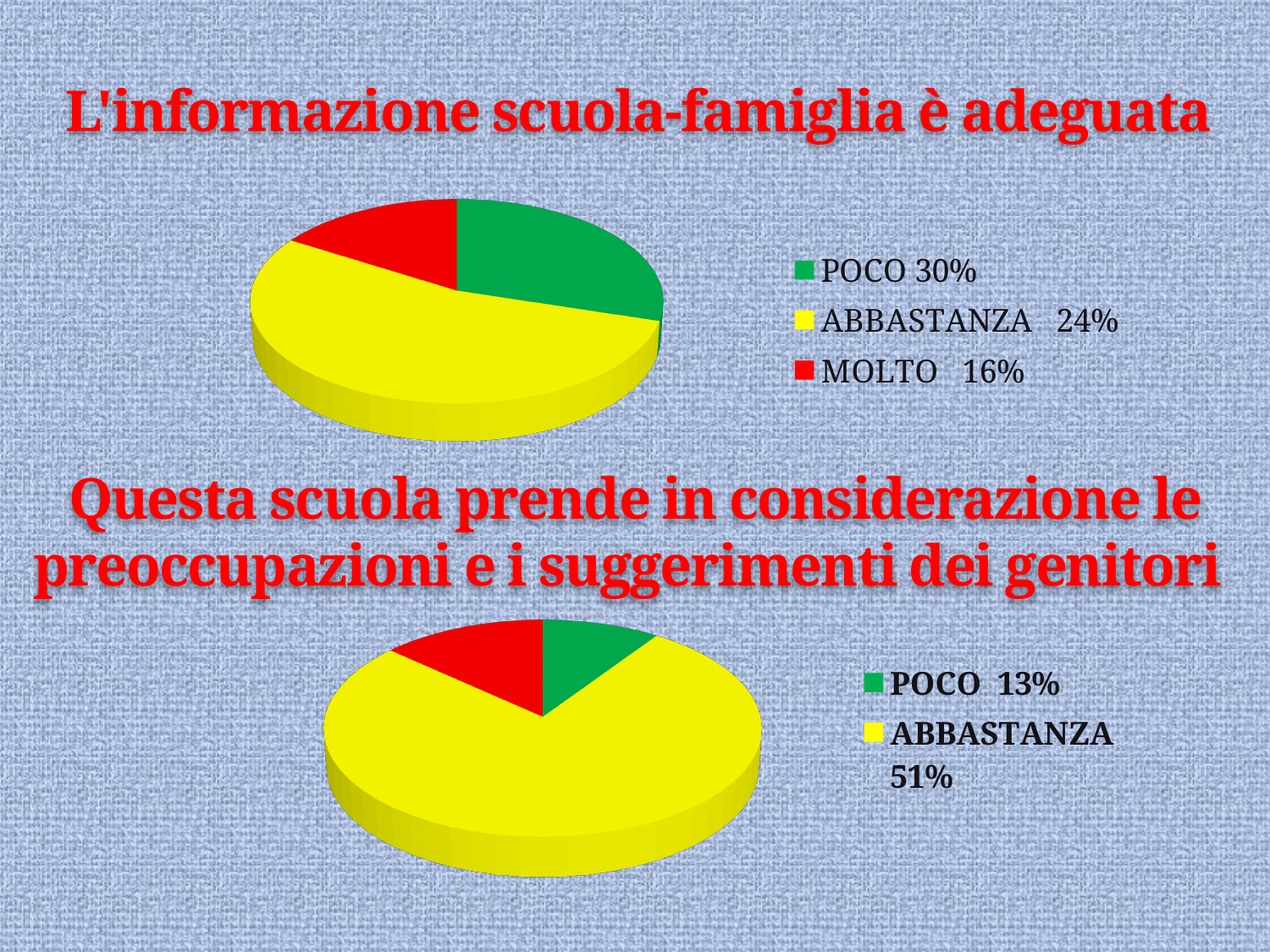
In the chart "Questa scuola prende in considerazione le preoccupazioni e i suggerimenti dei genitori", what percentage is shown for ABBASTANZA? 51% In the chart "L'informazione scuola-famiglia è adeguata", what percentage is shown for MOLTO? 16% How many entries does the legend of the chart "L'informazione scuola-famiglia è adeguata" list? 3 In the chart "Questa scuola prende in considerazione le preoccupazioni e i suggerimenti dei genitori", what is the difference between the percentages for ABBASTANZA and POCO? 38% In the chart "L'informazione scuola-famiglia è adeguata", what percentage is shown for POCO? 30% How many entries does the legend of the chart "Questa scuola prende in considerazione le preoccupazioni e i suggerimenti dei genitori" list? 2 In the chart "Questa scuola prende in considerazione le preoccupazioni e i suggerimenti dei genitori", which category has the largest slice? ABBASTANZA In the chart "Questa scuola prende in considerazione le preoccupazioni e i suggerimenti dei genitori", what percentage is shown for POCO? 13% In the chart "L'informazione scuola-famiglia è adeguata", what is the difference between the percentages for POCO and MOLTO? 14% In the chart "L'informazione scuola-famiglia è adeguata", which has the larger percentage, POCO or MOLTO? POCO What kind of chart is shown under the title "L'informazione scuola-famiglia è adeguata"? pie chart In the chart "L'informazione scuola-famiglia è adeguata", what percentage is shown for ABBASTANZA? 24%